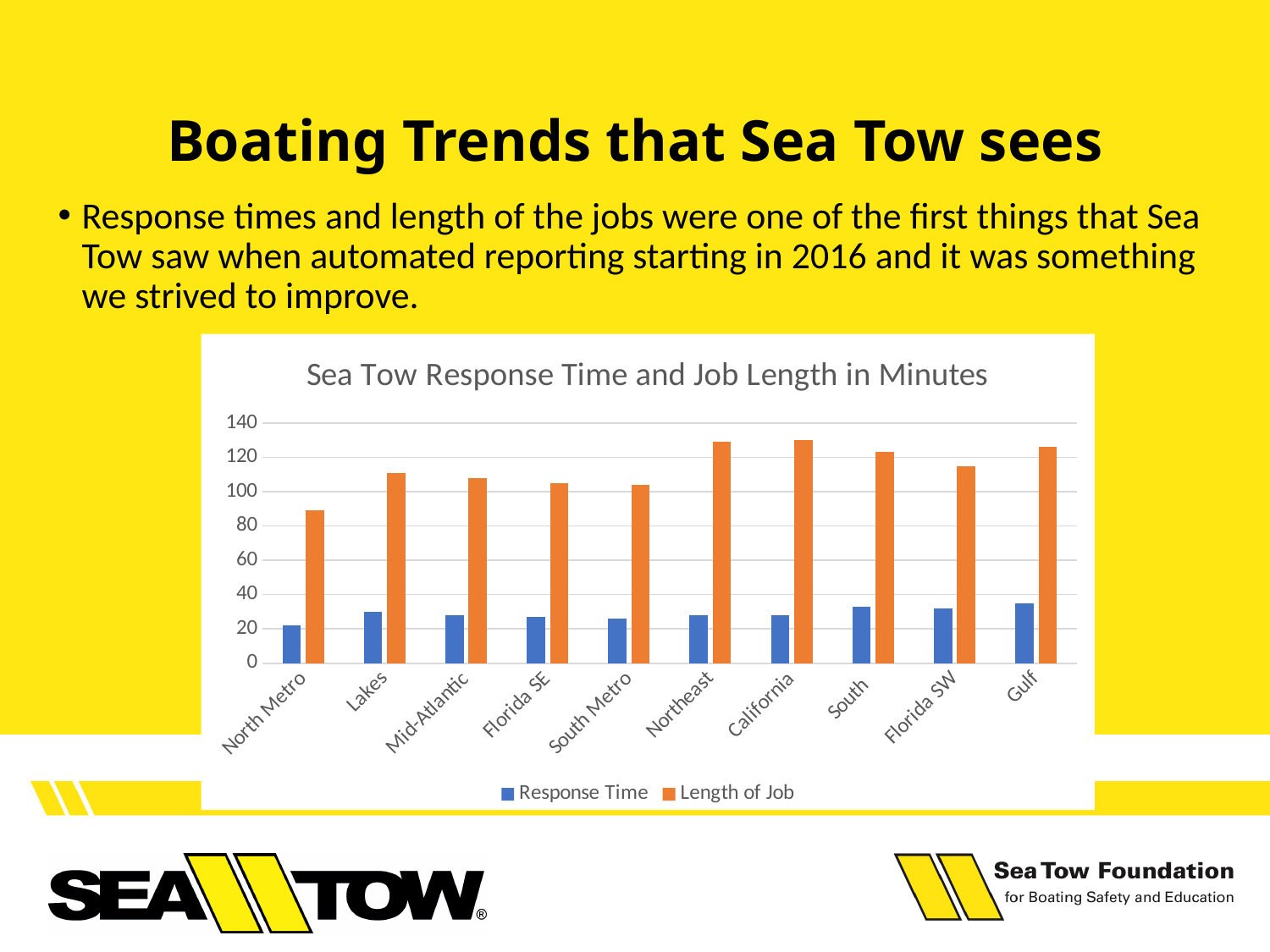
Which is larger, the Length of Job for Lakes or for North Metro? Lakes What is the title of the chart? Sea Tow Response Time and Job Length in Minutes How many regions are shown on the x axis of the chart? 10 Is the Length of Job for Florida SW greater or less than 100? greater What kind of chart is shown on the slide? bar chart Is the Length of Job for Northeast greater or less than 120? greater Which region has the lowest Response Time? North Metro Which is larger, the Response Time for Gulf or for North Metro? Gulf Is the Response Time for Gulf greater or less than 20? greater Which region has the lowest Length of Job? North Metro How many series does the chart legend list? 2